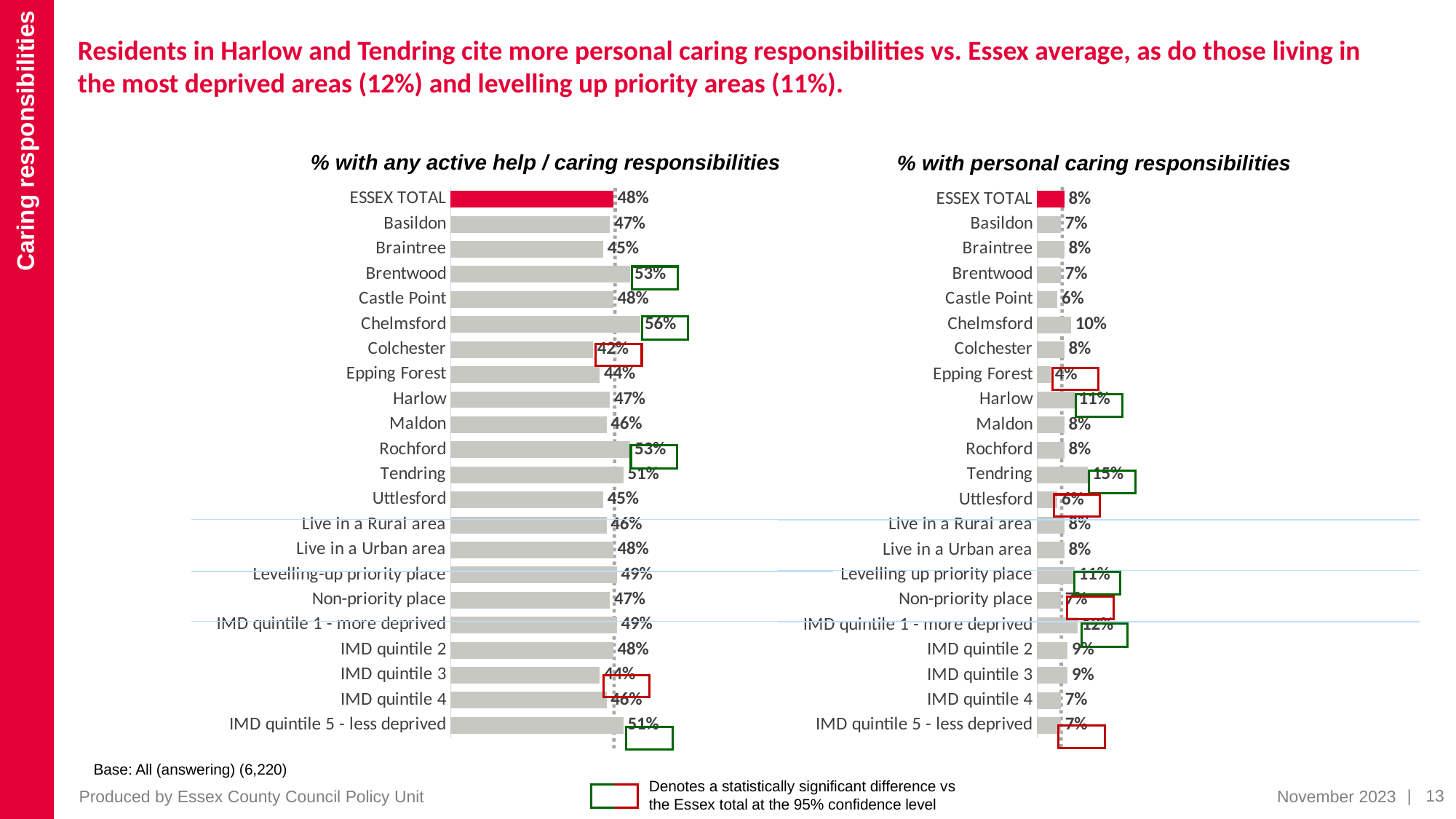
In the '% with personal caring responsibilities' chart, which category has the lowest value? Epping Forest In the '% with any active help / caring responsibilities' chart, which is larger, Brentwood or Tendring? Brentwood In the '% with any active help / caring responsibilities' chart, which category has the lowest value? Colchester In the '% with personal caring responsibilities' chart, what is the value for IMD quintile 1 - more deprived? 12% In the '% with personal caring responsibilities' chart, what is the value for Tendring? 15% In the '% with any active help / caring responsibilities' chart, which category has the highest value? Chelmsford In the '% with personal caring responsibilities' chart, which category has the highest value? Tendring How many categories are plotted in the '% with personal caring responsibilities' chart? 22 In the '% with any active help / caring responsibilities' chart, what is the difference between Chelmsford and ESSEX TOTAL? 8% In the '% with any active help / caring responsibilities' chart, what is the value for Chelmsford? 56% What type of chart is the '% with any active help / caring responsibilities' chart? Bar chart In the '% with personal caring responsibilities' chart, what is the difference between Harlow and Epping Forest? 7%